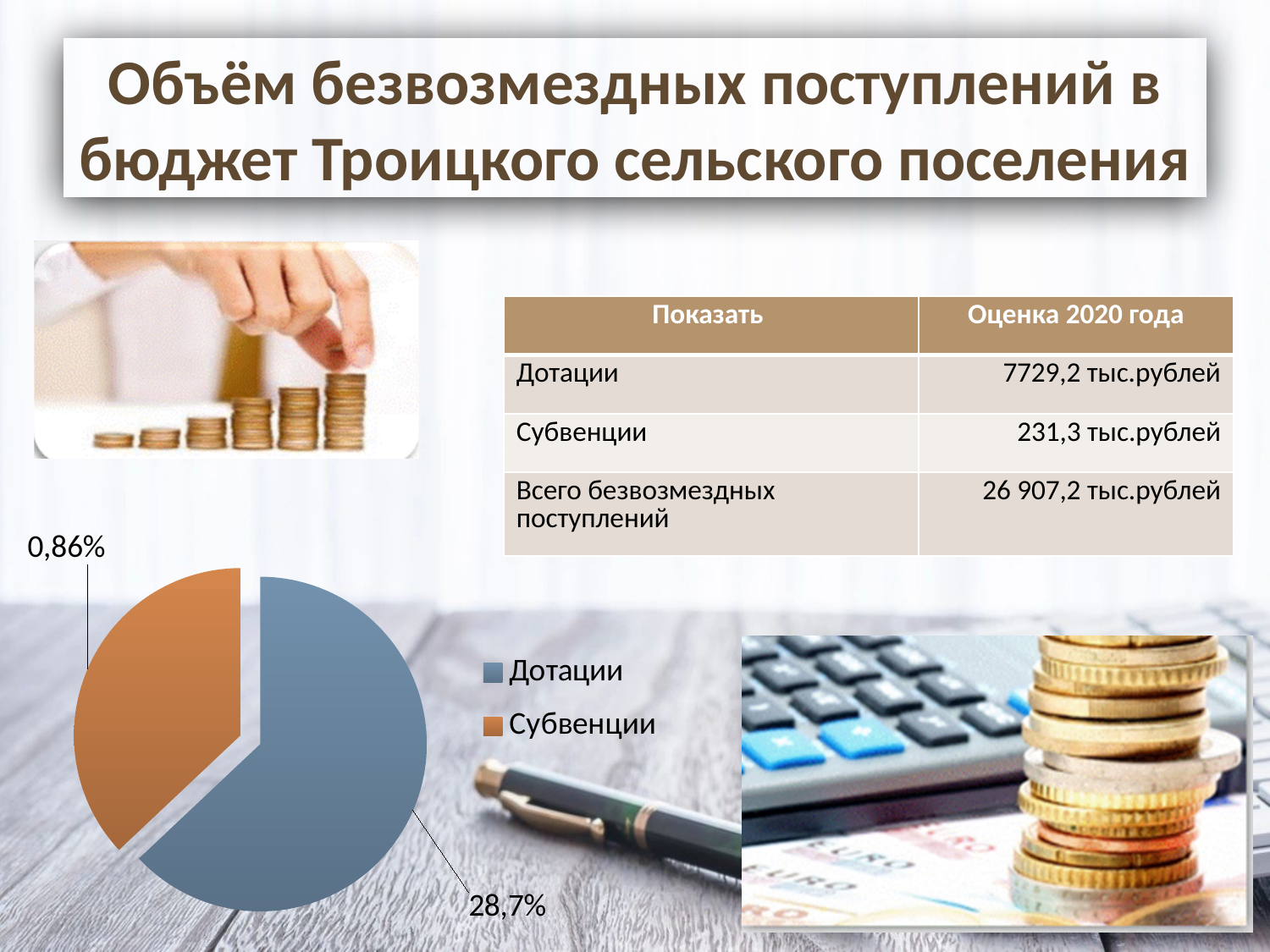
What colour is the Субвенции slice in the pie chart? orange In the pie chart, which is larger: Дотации or Субвенции? Дотации Which slice of the pie chart is the smallest? Субвенции What percentage is shown for Дотации in the pie chart? 28,7% What is the difference between the labelled percentages for Дотации and Субвенции in the pie chart? 27,84% What kind of chart is shown on the slide? pie chart What percentage is shown for Субвенции in the pie chart? 0,86% How many entries does the legend of the pie chart list? 2 What colour is the Дотации slice in the pie chart? blue How many slices does the pie chart have? 2 Which slice of the pie chart is the largest? Дотации